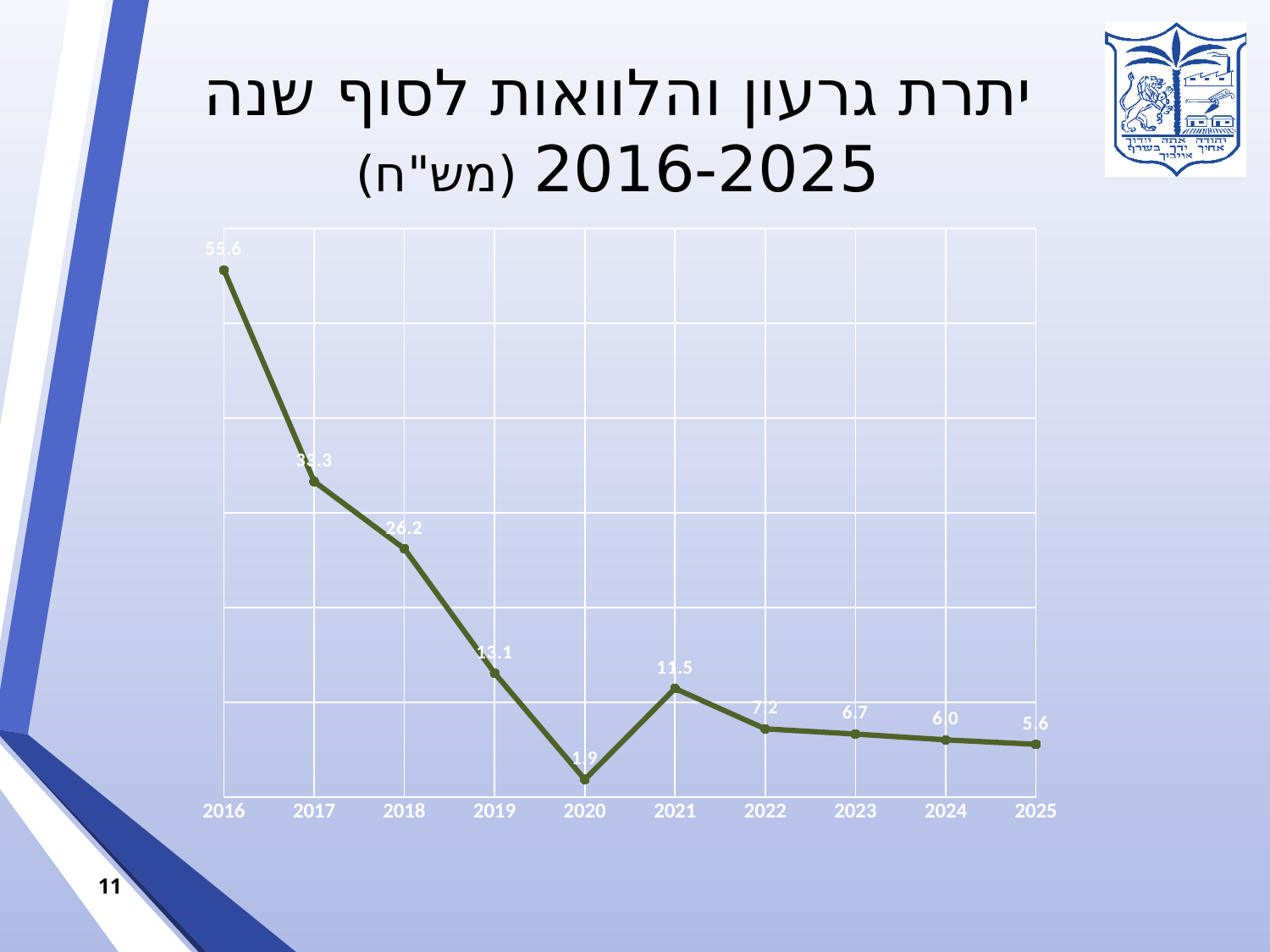
What is the value for 2021? 11.5 How many years are plotted on the x axis? 10 What is the value for 2016? 55.6 What is the difference between the values for 2021 and 2022? 4.3 Do the values generally rise or fall from 2016 to 2020? Fall What is the value for 2020? 1.9 Which is larger, the value for 2019 or the value for 2021? 2019 What kind of chart is shown on the slide? Line chart Which year has the highest value? 2016 What is the difference between the values for 2016 and 2017? 22.3 Which year has the lowest value? 2020 What is the value for 2025? 5.6